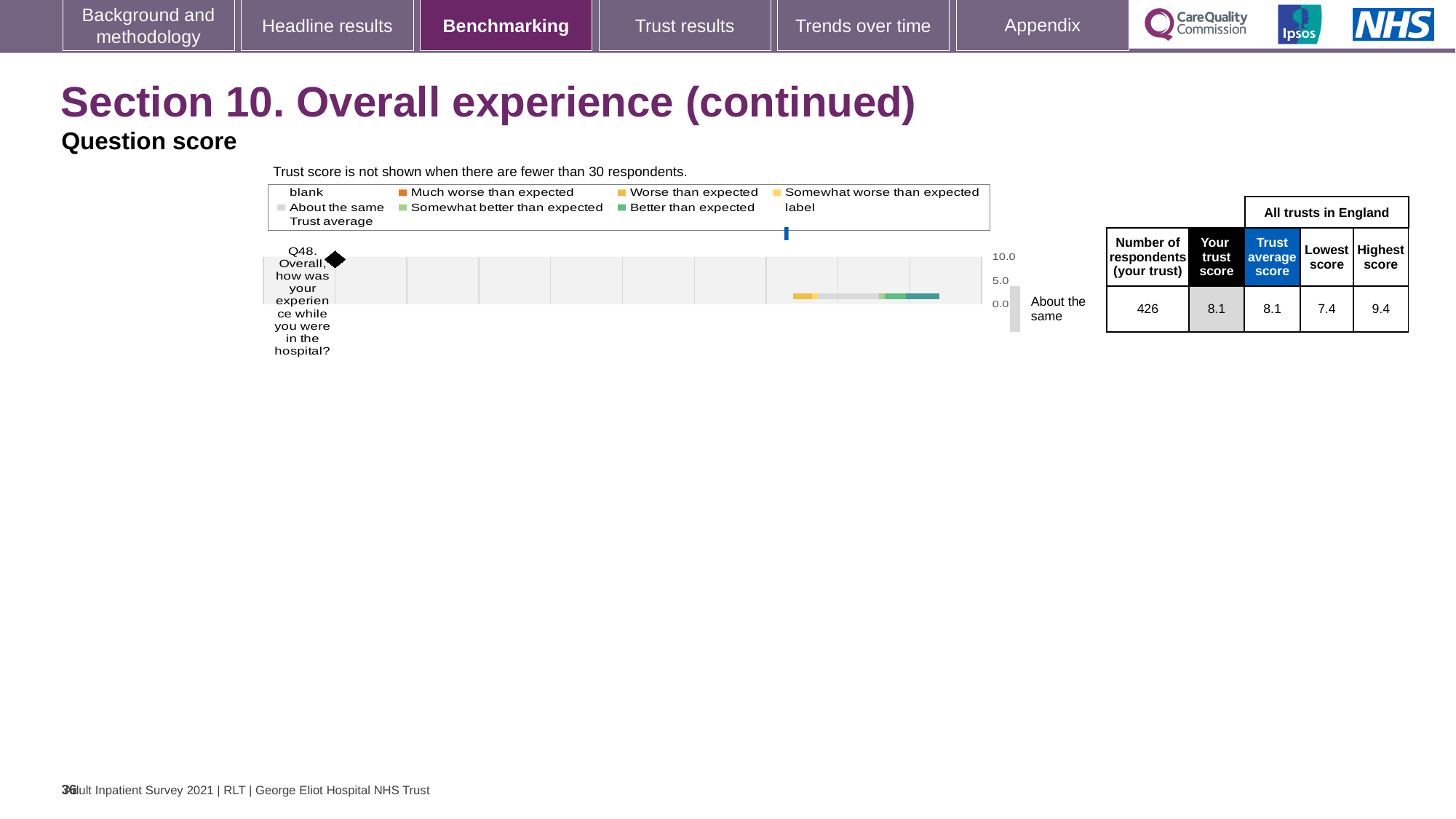
What is the trust average score for Q48 across all trusts in England? 8.1 How many questions are plotted in the benchmarking chart? 1 What is the trust's score for Q48, as shown next to the chart? 8.1 How is the trust's result for Q48 categorised relative to expectations? About the same What is the highest value shown on the chart's score axis? 10.0 What is the highest score among all trusts in England for Q48? 9.4 What is the difference between the highest score and the lowest score among all trusts in England for Q48? 2.0 Which question is plotted in the benchmarking chart? Q48. Overall, how was your experience while you were in the hospital? What is the lowest score among all trusts in England for Q48? 7.4 What kind of chart is used to show the benchmarking result for Q48? bar chart Is the trust's score for Q48 greater or less than 5.0 on the chart's axis? greater How many respondents from the trust answered Q48? 426